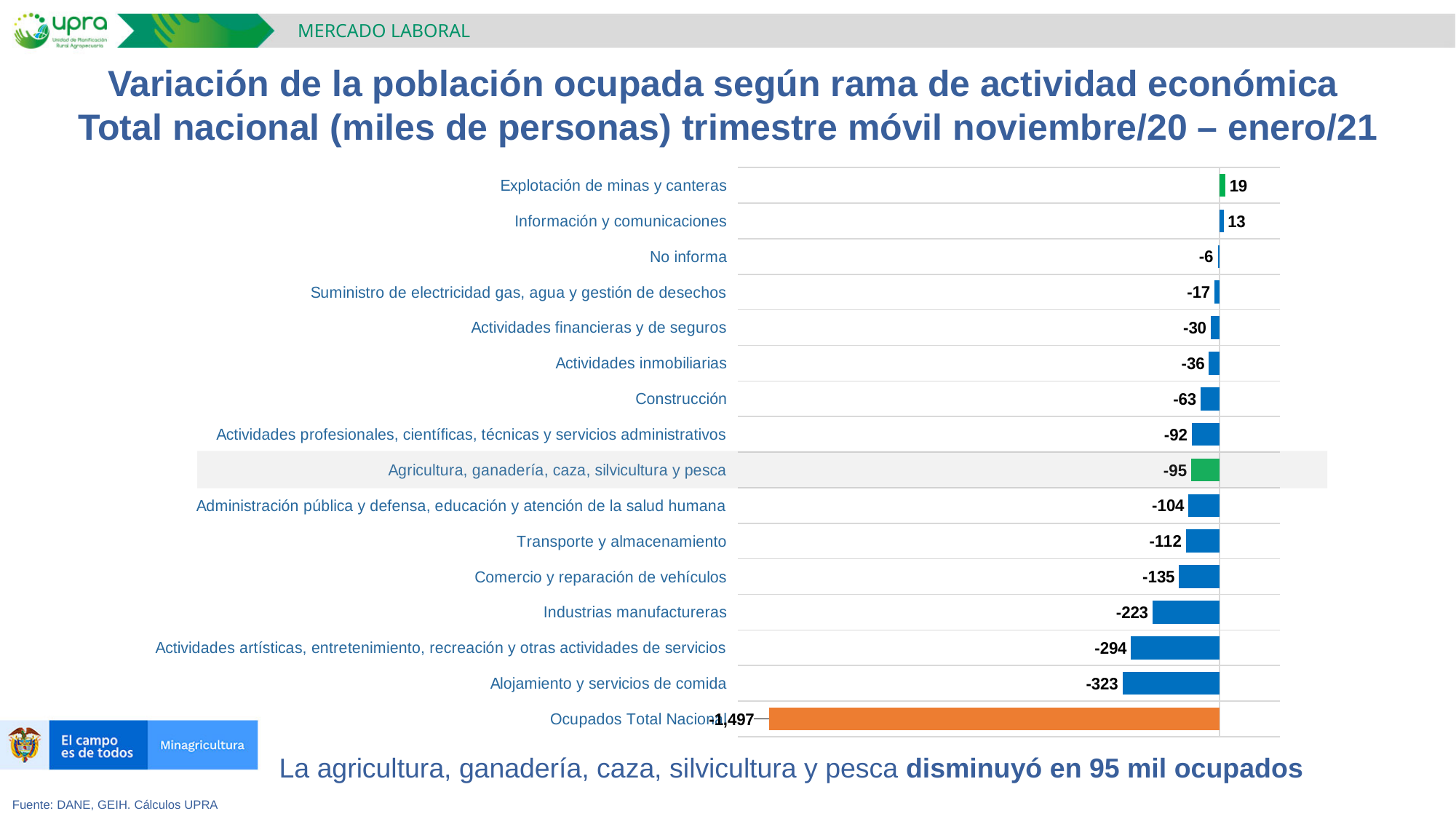
What is the difference between the values for Actividades artísticas, entretenimiento, recreación y otras actividades de servicios and Alojamiento y servicios de comida? 29 How many categories are shown in the chart? 16 What colour is the bar for Agricultura, ganadería, caza, silvicultura y pesca? Green What is the value for Ocupados Total Nacional? -1,497 What kind of chart is shown on the slide? Bar chart What is the difference between the values for Explotación de minas y canteras and Información y comunicaciones? 6 Which category has the lowest value? Ocupados Total Nacional What is the value for Agricultura, ganadería, caza, silvicultura y pesca? -95 What is the value for Información y comunicaciones? 13 Which is larger, the value for Comercio y reparación de vehículos or the value for Industrias manufactureras? Comercio y reparación de vehículos Which category has the highest value? Explotación de minas y canteras What is the value for Alojamiento y servicios de comida? -323